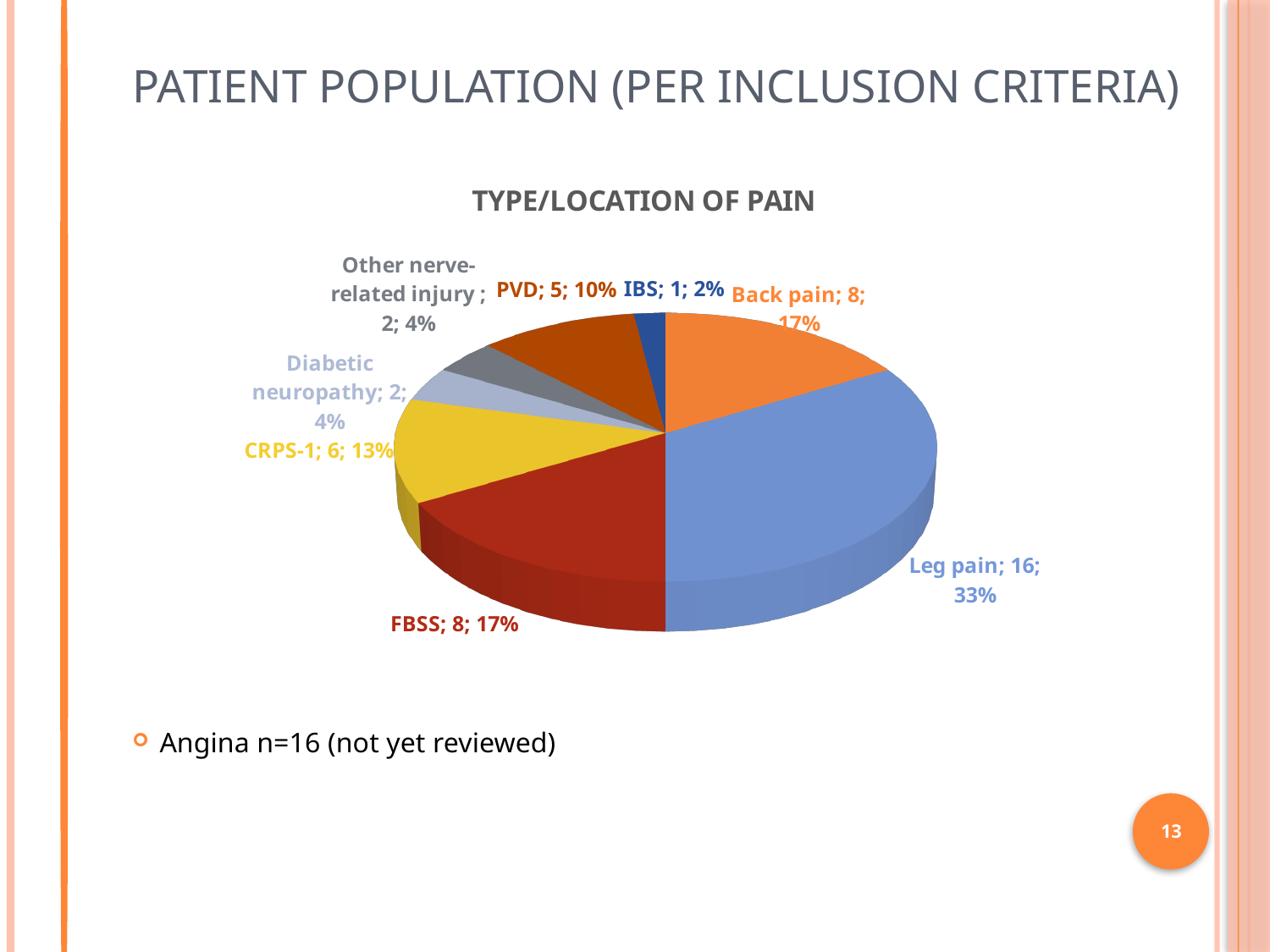
Which has more patients, CRPS-1 or PVD? CRPS-1 How many patients are in the Leg pain category? 16 How many categories does the pie chart show? 8 Which category has the largest slice of the pie? Leg pain What is the count for PVD? 5 What is the title of the chart? TYPE/LOCATION OF PAIN Which category has the smallest slice of the pie? IBS What is the total number of patients across all slices of the pie? 48 What percentage share does Diabetic neuropathy have? 4% What is the difference in patient count between Leg pain and FBSS? 8 What kind of chart is shown on the slide? Pie chart What percentage share of the pie does Back pain have? 17%